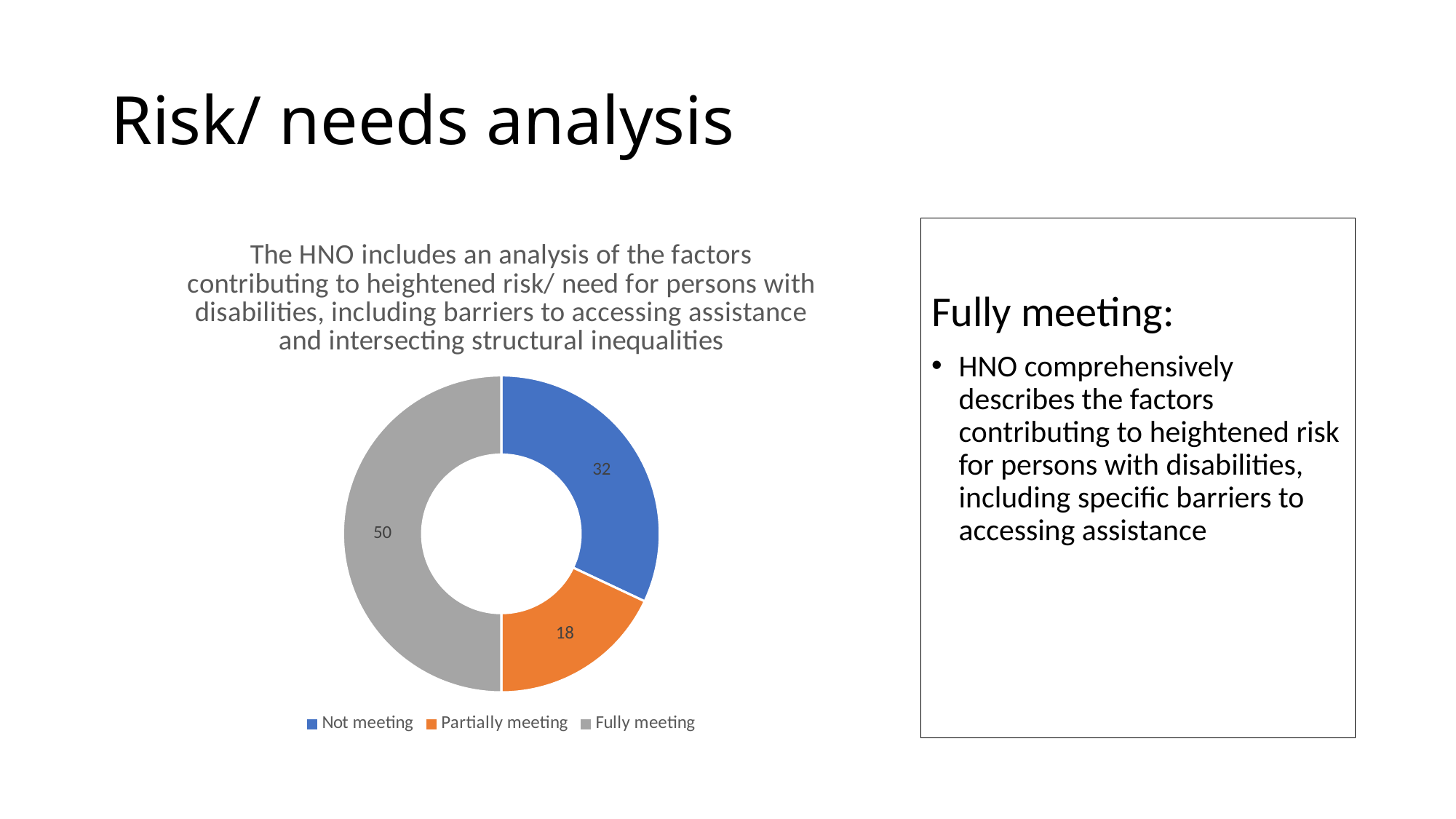
Which category has the lowest value? Partially meeting Which category has the highest value? Fully meeting What is the difference between the values for Not meeting and Partially meeting? 14 What share of the total does Fully meeting represent? 50% What is the value for Fully meeting? 50 Which is larger, the value for Not meeting or the value for Partially meeting? Not meeting What colour represents Partially meeting in the chart? Orange What is the difference between the values for Fully meeting and Not meeting? 18 What kind of chart is shown on the slide? Doughnut chart What is the value for Not meeting? 32 How many categories does the chart show? 3 What is the value for Partially meeting? 18